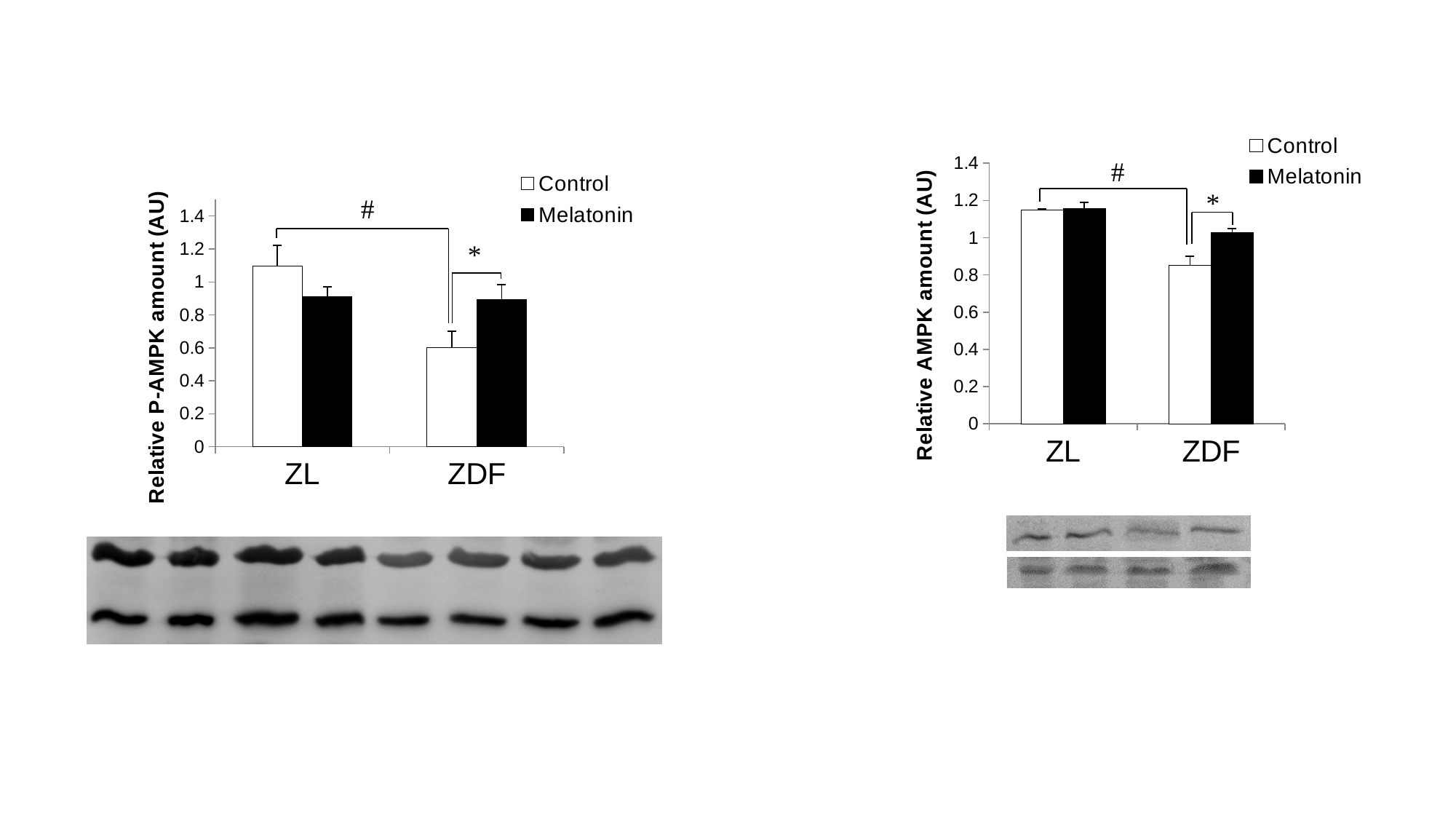
In the right chart (Relative AMPK amount), is the value for ZDF Control greater or less than 1? less In the right chart (Relative AMPK amount), which is larger for ZDF: Control or Melatonin? Melatonin How many series does the legend of the left chart list? 2 In the left chart (Relative P-AMPK amount), which bar is the lowest? ZDF Control In the right chart (Relative AMPK amount), is the value for ZL Melatonin greater or less than 1? greater How many categories are shown on the x axis of the right chart? 2 In the left chart (Relative P-AMPK amount), which is larger for ZDF: Control or Melatonin? Melatonin What kind of chart is the left chart (Relative P-AMPK amount)? Bar chart In the left chart (Relative P-AMPK amount), is the value for ZL Control greater or less than 1? greater In the left chart (Relative P-AMPK amount), which bar is the highest? ZL Control In the right chart (Relative AMPK amount), which bar is the lowest? ZDF Control